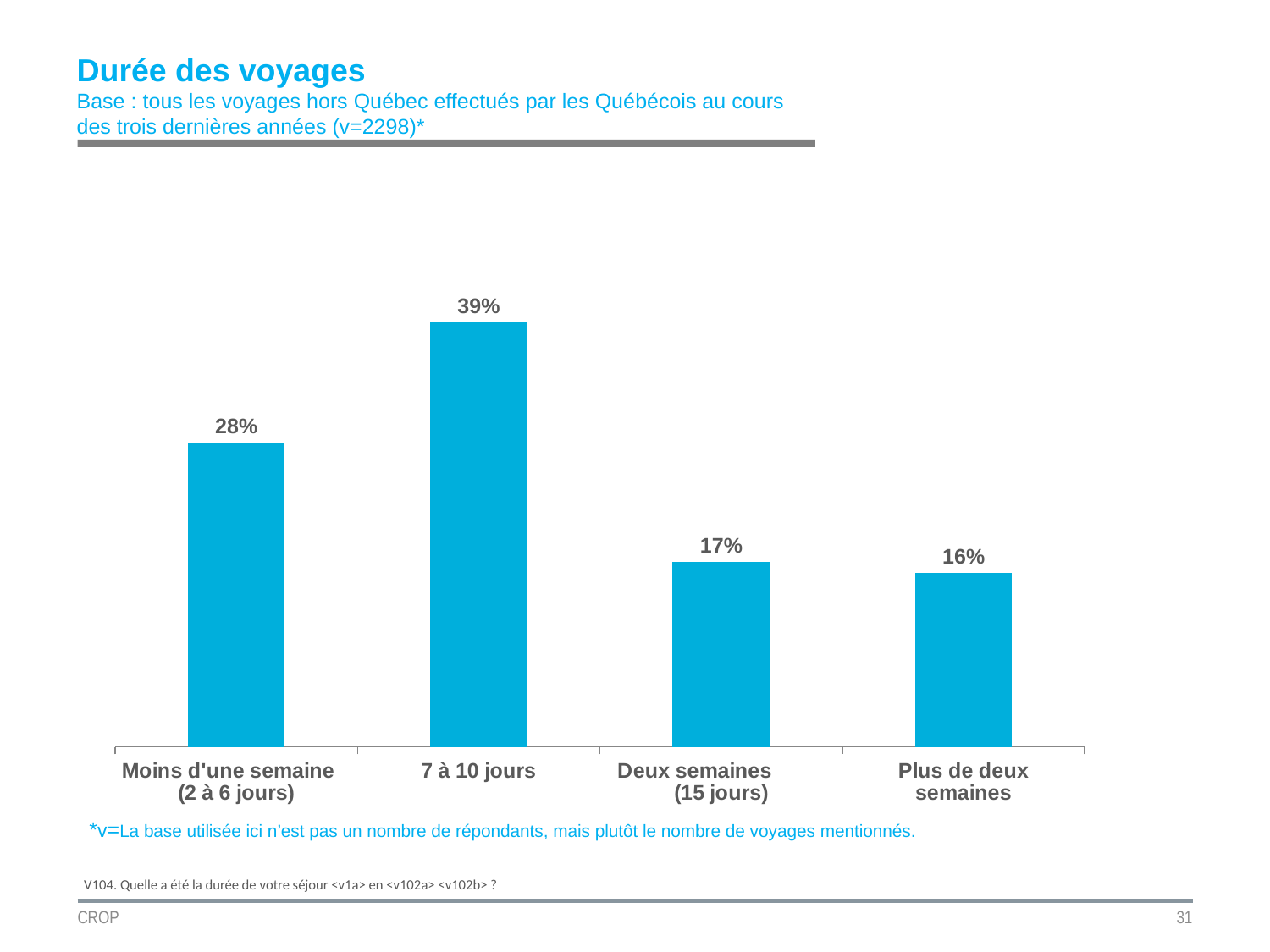
How many trip duration categories are shown in the chart? 4 What percentage of trips lasted 7 à 10 jours? 39% What kind of chart is shown on the slide? Bar chart Which is larger: the value for Moins d'une semaine (2 à 6 jours) or the value for Deux semaines (15 jours)? Moins d'une semaine (2 à 6 jours) What is the value for Plus de deux semaines? 16% Which trip duration category has the highest percentage? 7 à 10 jours What is the title of the slide? Durée des voyages What is the value for Deux semaines (15 jours)? 17% What is the difference between the values for 7 à 10 jours and Moins d'une semaine (2 à 6 jours)? 11% Which trip duration category has the lowest percentage? Plus de deux semaines What is the difference between the values for Deux semaines (15 jours) and Plus de deux semaines? 1% What is the value for Moins d'une semaine (2 à 6 jours)? 28%